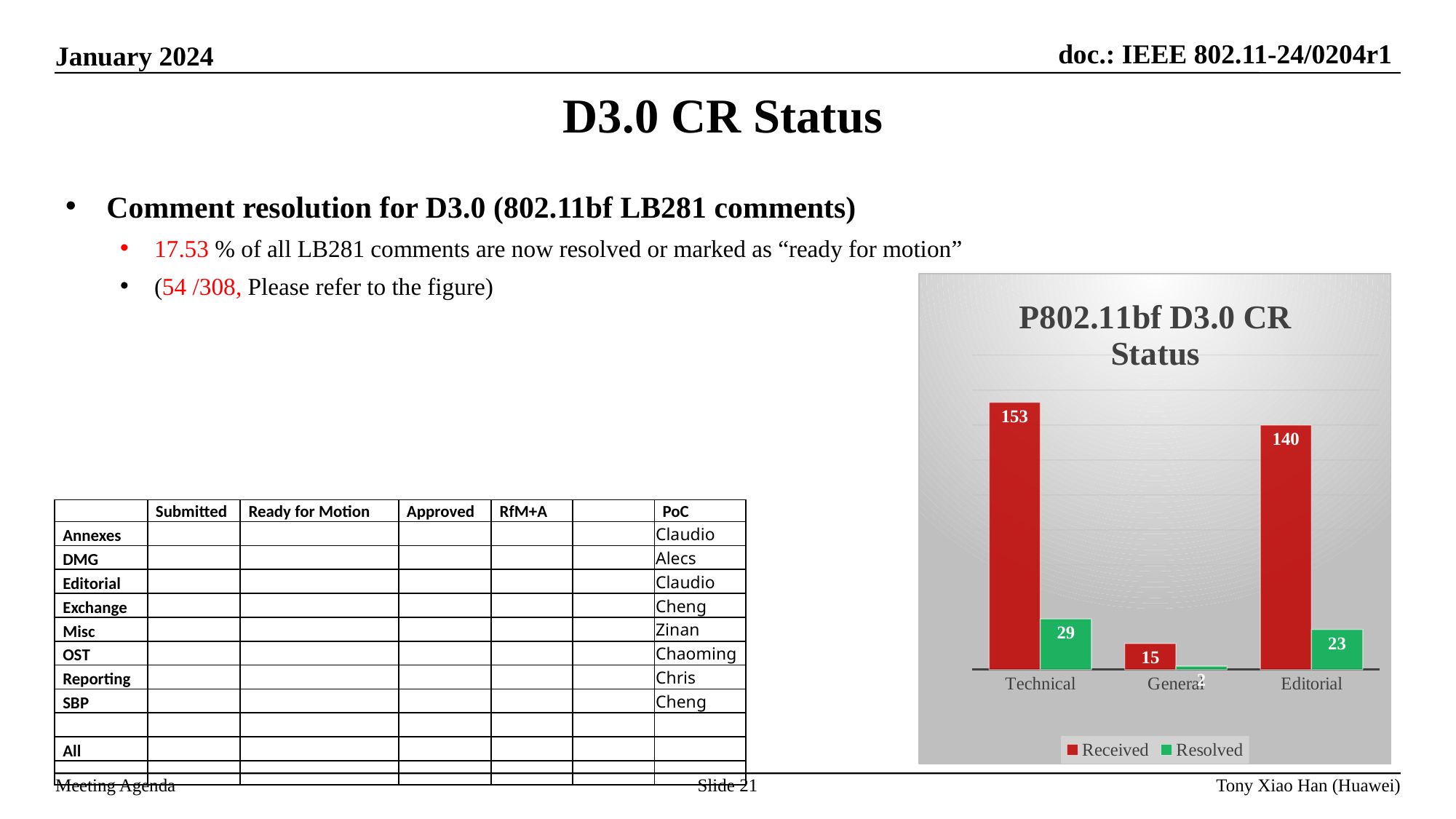
What is the Resolved value for Editorial? 23 What is the difference between the Received values for Technical and Editorial? 13 How many categories are shown on the x axis of the chart? 3 Which category has the highest Received value? Technical How many series does the chart legend list? 2 What is the Received value for General? 15 What is the Received value for Technical? 153 What type of chart is shown on the slide? bar chart Which is larger, the Resolved value for Technical or the Resolved value for Editorial? Technical Which series is shown in red in the chart? Received Which category has the lowest Received value? General What is the title of the chart on the slide? P802.11bf D3.0 CR Status